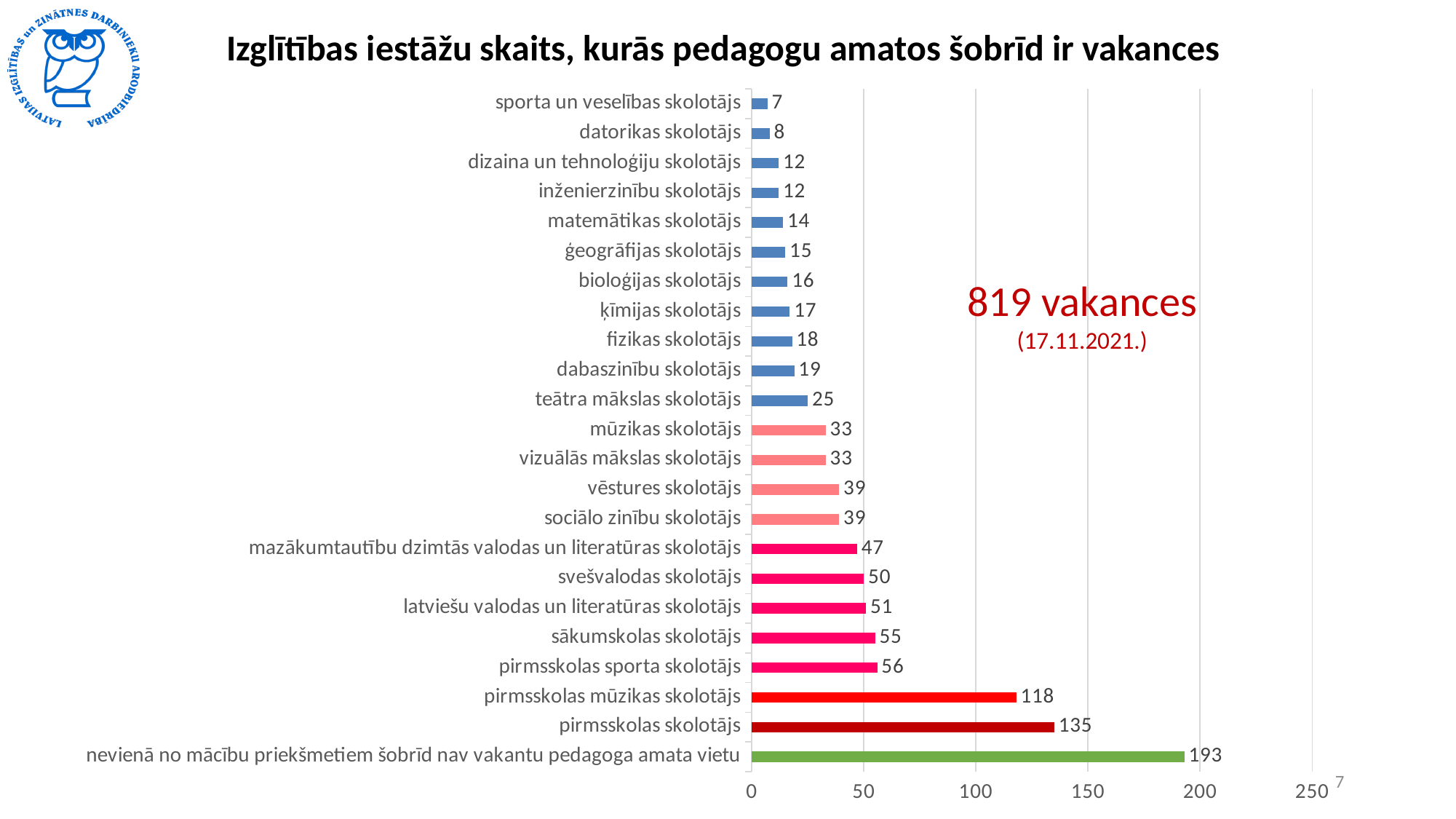
Which category has the lowest value? sporta un veselības skolotājs What kind of chart is shown on the slide? bar chart What is the value for svešvalodas skolotājs? 50 What is the difference between the values for pirmsskolas skolotājs and pirmsskolas mūzikas skolotājs? 17 What is the value for matemātikas skolotājs? 14 Which category has the highest value? nevienā no mācību priekšmetiem šobrīd nav vakantu pedagoga amata vietu What is the title of the chart? Izglītības iestāžu skaits, kurās pedagogu amatos šobrīd ir vakances How many categories are shown in the chart? 23 Is the value for pirmsskolas mūzikas skolotājs greater or less than 100? greater Which is larger, the value for vēstures skolotājs or the value for mūzikas skolotājs? vēstures skolotājs What is the difference between the values for sākumskolas skolotājs and teātra mākslas skolotājs? 30 What is the value for pirmsskolas skolotājs? 135